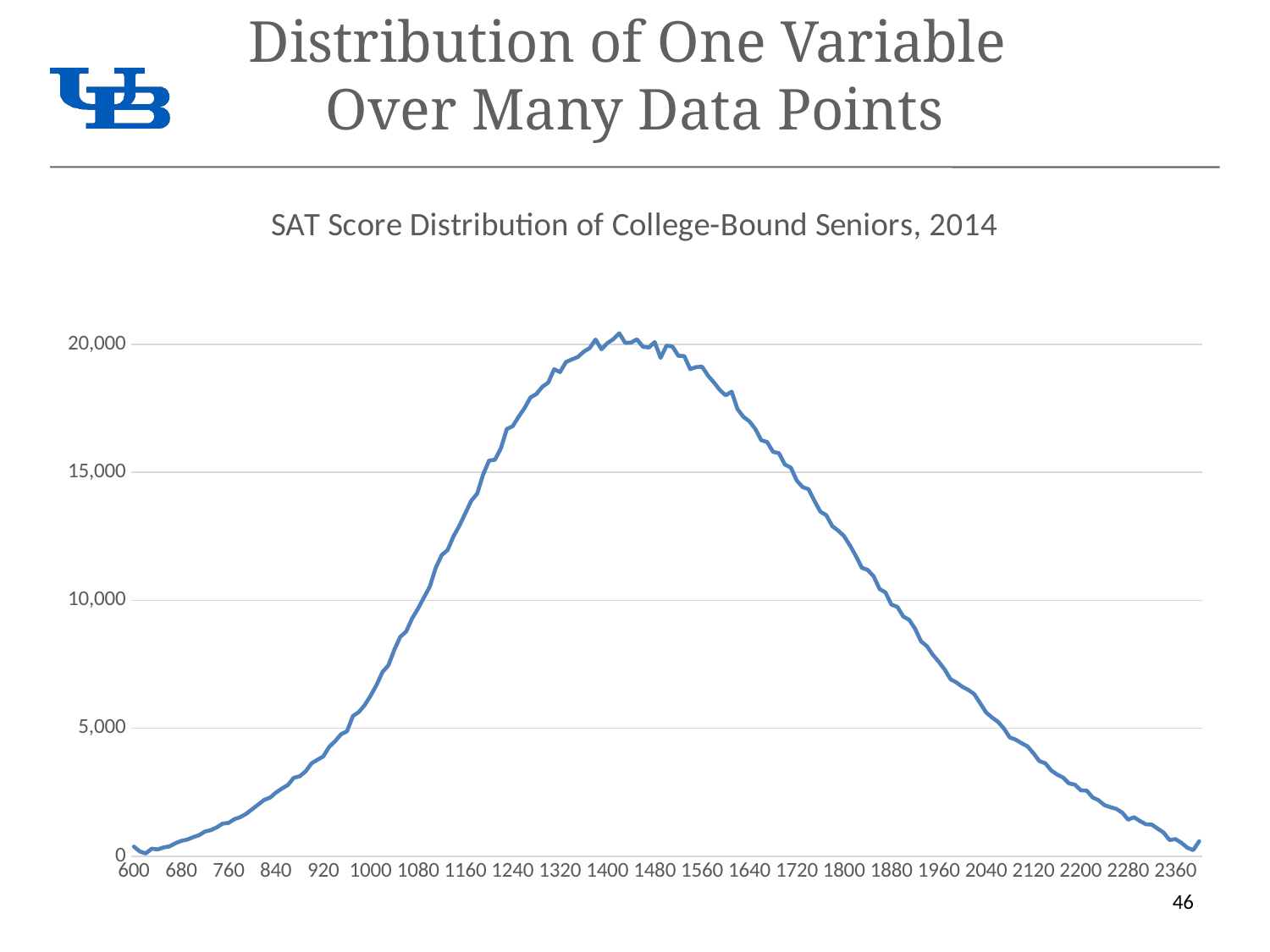
Is the value at an SAT score of 1240 greater or less than 15,000? greater What is the highest value labelled on the vertical axis? 20,000 Is the value at an SAT score of 1960 greater or less than 10,000? less What kind of chart is shown on the slide? line chart Is the value at an SAT score of 920 greater or less than 5,000? less What is the title of the chart? SAT Score Distribution of College-Bound Seniors, 2014 Which has the larger value: an SAT score of 1400 or an SAT score of 2000? 1400 Does the line rise or fall as the SAT score goes from 1480 to 2360? falls Does the line rise or fall as the SAT score goes from 600 to 1400? rises